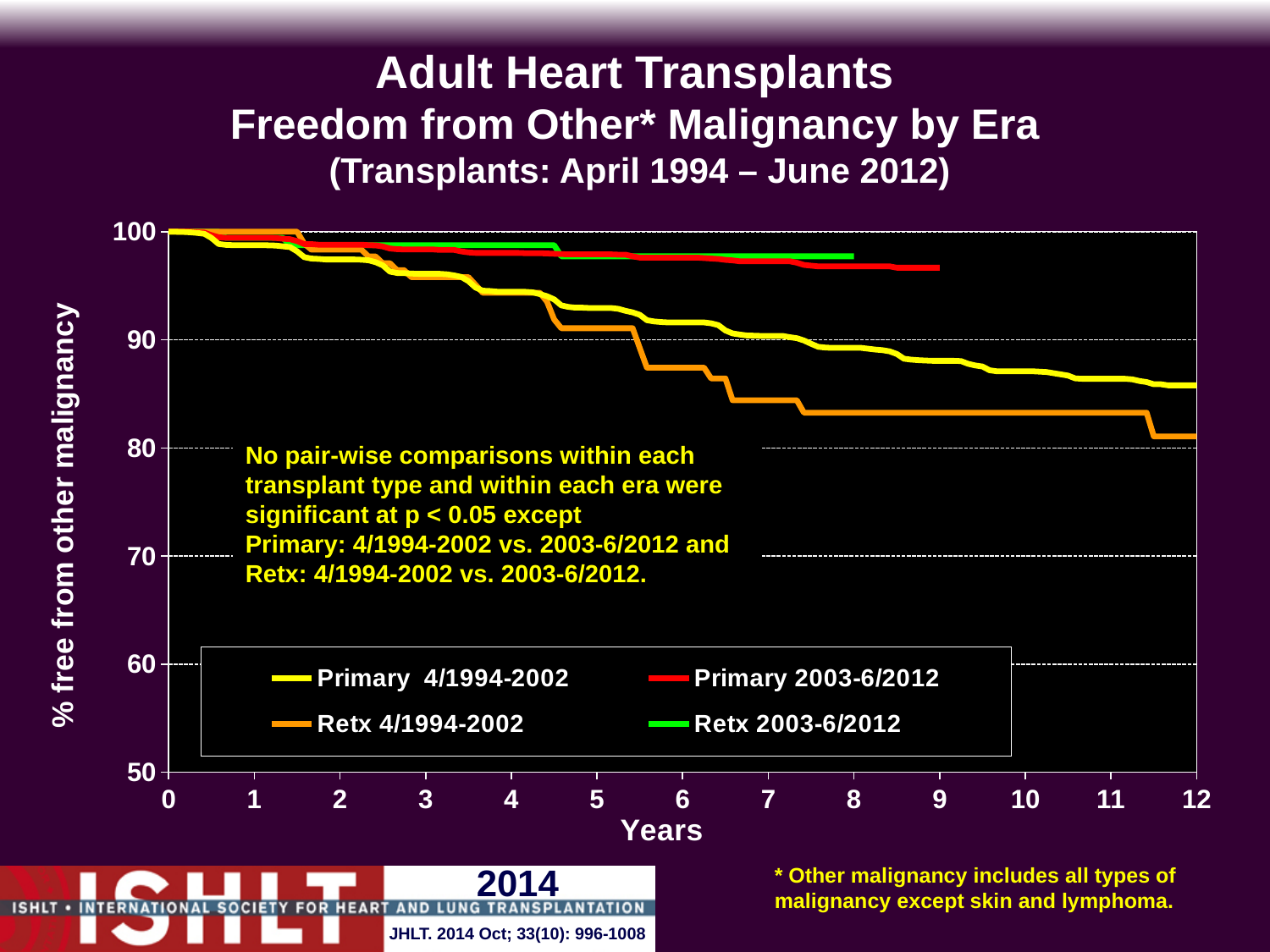
Is the value for Primary 4/1994-2002 at 12 years greater or less than 80? greater At 12 years, which is higher: Primary 4/1994-2002 or Retx 4/1994-2002? Primary 4/1994-2002 What is the highest value shown on the x axis? 12 Is the value for Primary 2003-6/2012 at 8 years greater or less than 90? greater Is the value for Retx 4/1994-2002 at 6 years greater or less than 90? less Which colour represents Retx 2003-6/2012 in the legend? green What is the label of the y axis? % free from other malignancy Which series has the lowest value at 12 years? Retx 4/1994-2002 Do the curves rise or fall as the number of years increases? fall What kind of chart is shown on the slide? line chart How many series does the legend list? 4